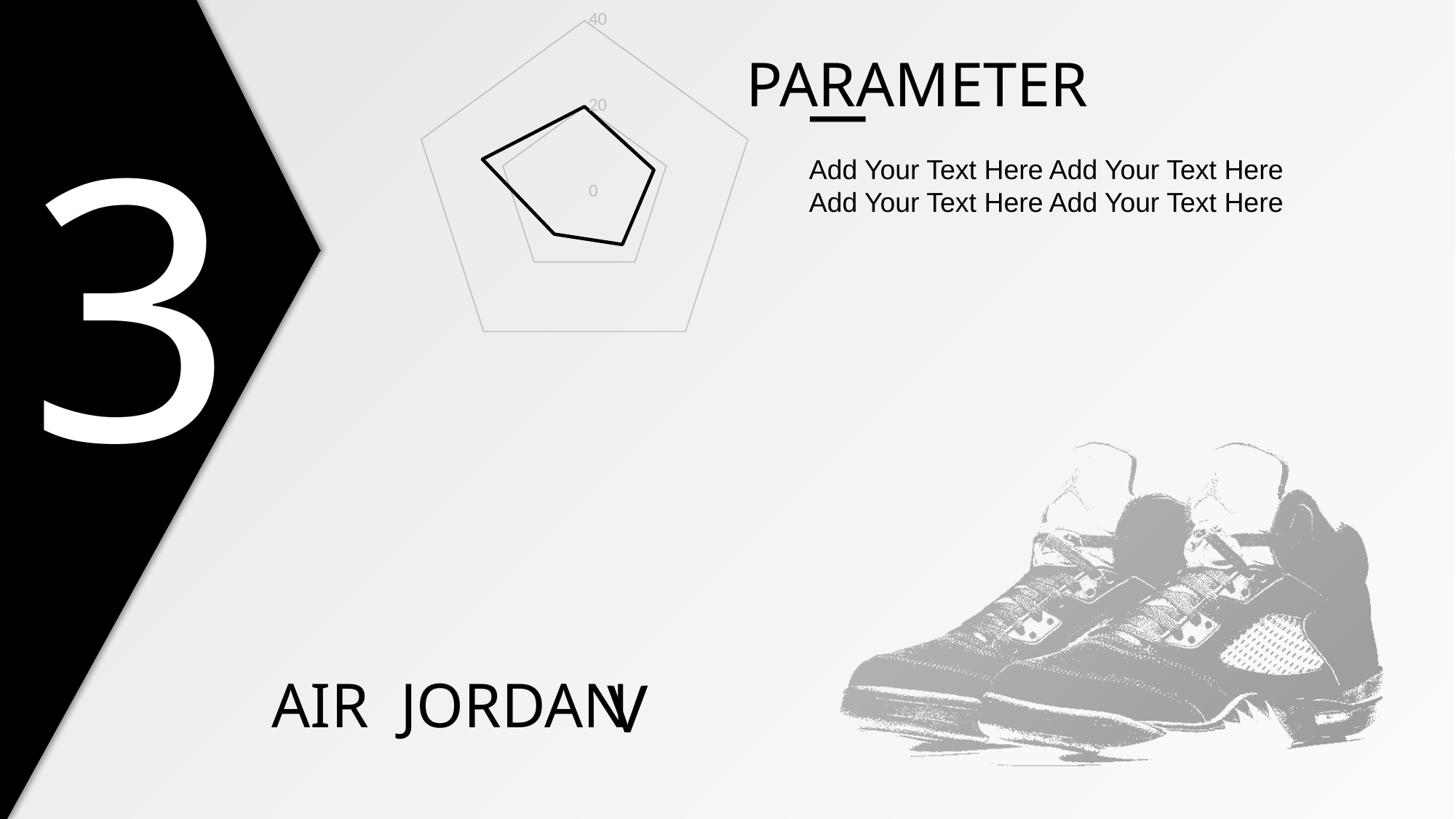
How many axes (categories) does the radar chart have? 5 Is the value on the lower-left axis of the radar chart greater or less than 20? less What is the highest value labelled on the radar chart's axis? 40 Does any point on the radar chart reach the 40 ring? No What kind of chart is shown on the slide? radar chart What is the lowest value labelled on the radar chart's axis? 0 Is the value on the left-pointing axis of the radar chart greater or less than 20? greater How many data series are plotted on the radar chart? 1